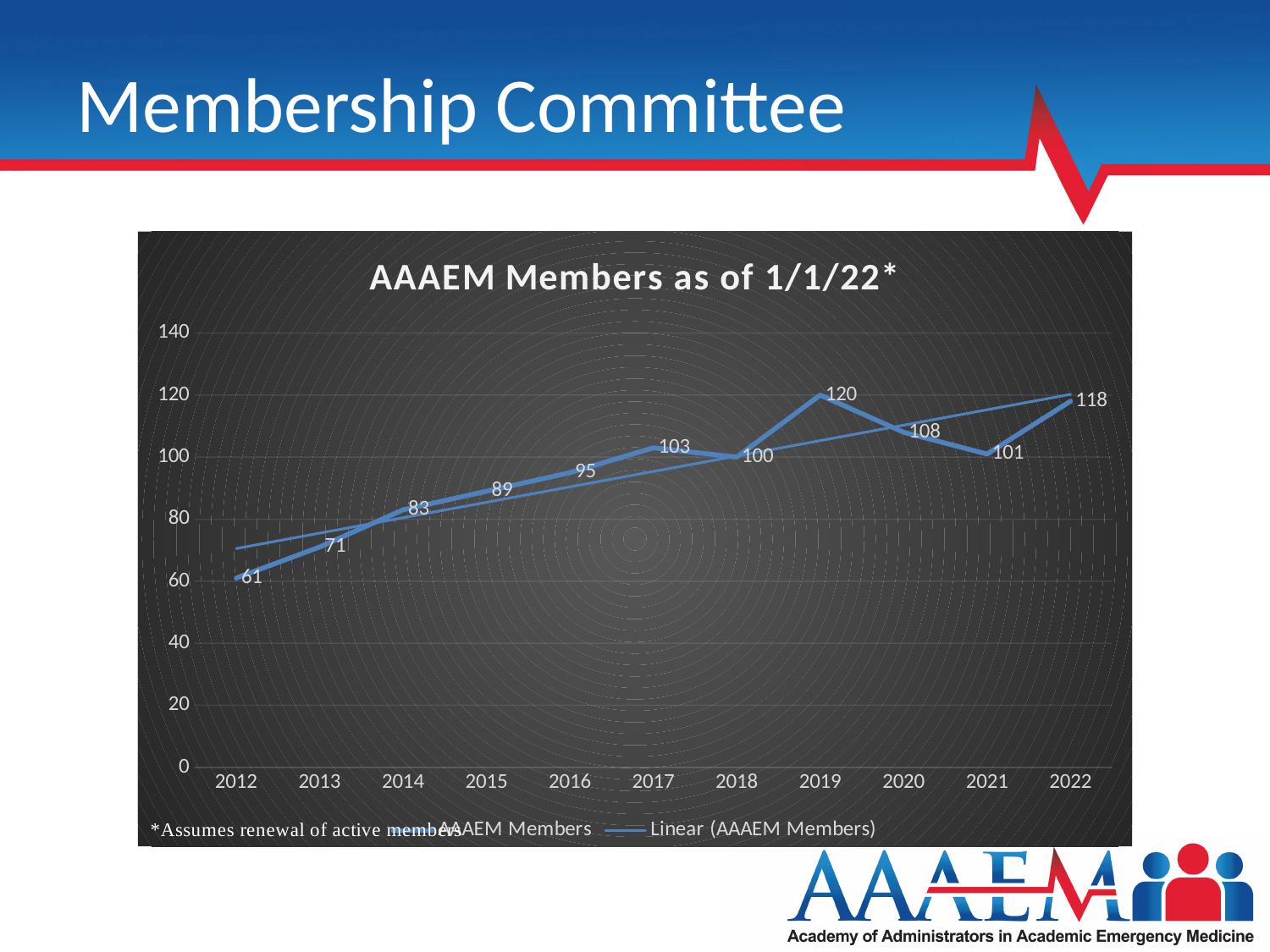
What is the value for 2019? 120 What is the difference between the values for 2019 and 2018? 20 How many AAAEM members were there in 2012? 61 Which year has the lowest number of AAAEM members? 2012 How many years are plotted on the x axis? 11 What is the value for 2022? 118 Does the number of members generally rise or fall from 2012 to 2017? rise Which year has a larger value, 2020 or 2021? 2020 What is the title of the chart? AAAEM Members as of 1/1/22* How many entries does the legend list? 2 What type of chart is shown on the slide? line chart Which year has the highest number of AAAEM members? 2019